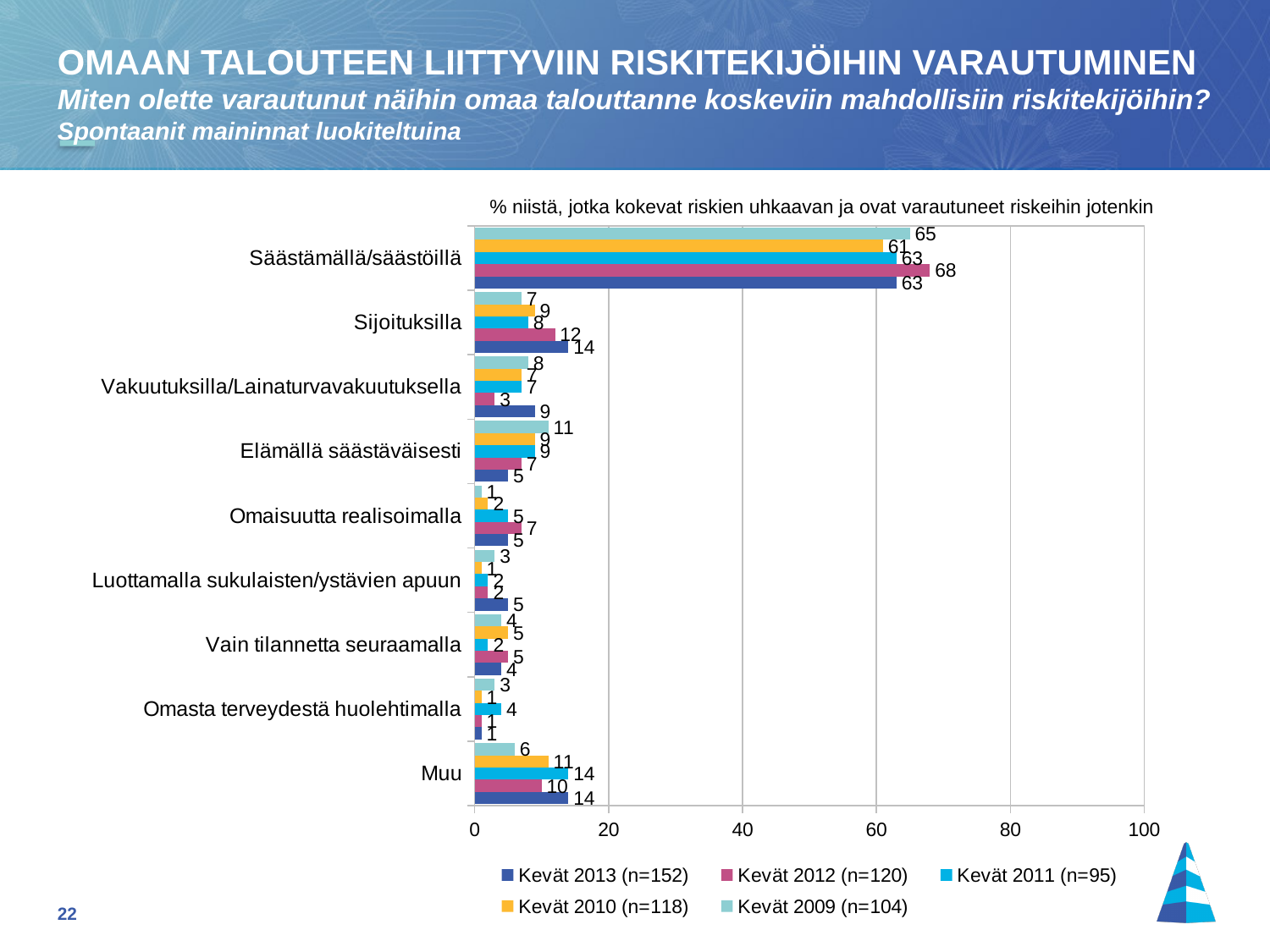
Is the Kevät 2009 (n=104) value for Säästämällä/säästöillä greater or less than 60? greater What is the value for Elämällä säästäväisesti in the Kevät 2009 (n=104) series? 11 For Vakuutuksilla/Lainaturvavakuutuksella, which is larger: the Kevät 2013 (n=152) value or the Kevät 2012 (n=120) value? Kevät 2013 (n=152) What is the value for Sijoituksilla in the Kevät 2013 (n=152) series? 14 What is the value for Muu in the Kevät 2010 (n=118) series? 11 How many categories are shown on the vertical axis? 9 What is the sample size (n) shown in the legend for Kevät 2011? 95 What is the difference between the Kevät 2012 (n=120) and Kevät 2010 (n=118) values for Säästämällä/säästöillä? 7 Which category has the highest value in the Kevät 2013 (n=152) series? Säästämällä/säästöillä How many series does the legend list? 5 What is the value for Säästämällä/säästöillä in the Kevät 2012 (n=120) series? 68 What kind of chart is shown on the slide? bar chart